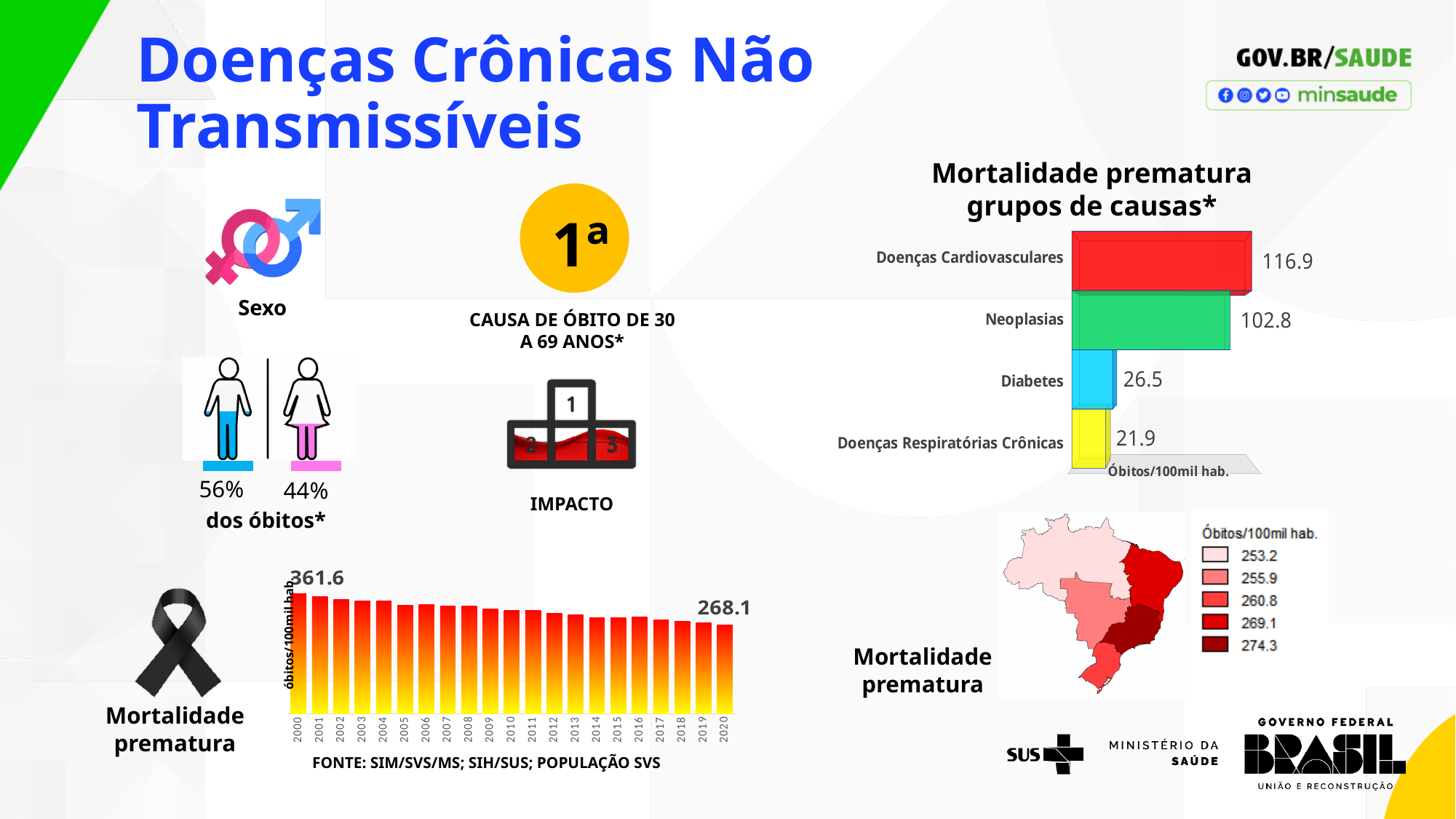
In the 'Mortalidade prematura grupos de causas*' chart, which cause group has the lowest value? Doenças Respiratórias Crônicas In the 'Mortalidade prematura grupos de causas*' chart, what is the difference between Doenças Cardiovasculares and Neoplasias? 14.1 In the 'Mortalidade prematura' bar chart at the bottom of the slide, what is the value for 2020? 268.1 In the 'Mortalidade prematura grupos de causas*' chart, which cause group has the highest value? Doenças Cardiovasculares In the 'Mortalidade prematura grupos de causas*' chart, what is the value for Doenças Respiratórias Crônicas? 21.9 In the 'Mortalidade prematura grupos de causas*' chart, what is the value for Neoplasias? 102.8 In the 'Mortalidade prematura' bar chart at the bottom of the slide, what is the value for 2000? 361.6 What kind of chart is the 'Mortalidade prematura grupos de causas*' chart? Bar chart In the 'Mortalidade prematura grupos de causas*' chart, what is the value for Doenças Cardiovasculares? 116.9 In the 'Mortalidade prematura grupos de causas*' chart, how many cause groups are shown? 4 In the 'Mortalidade prematura grupos de causas*' chart, what is the value for Diabetes? 26.5 In the 'Mortalidade prematura' bar chart at the bottom of the slide, do the values rise or fall from 2000 to 2020? Fall